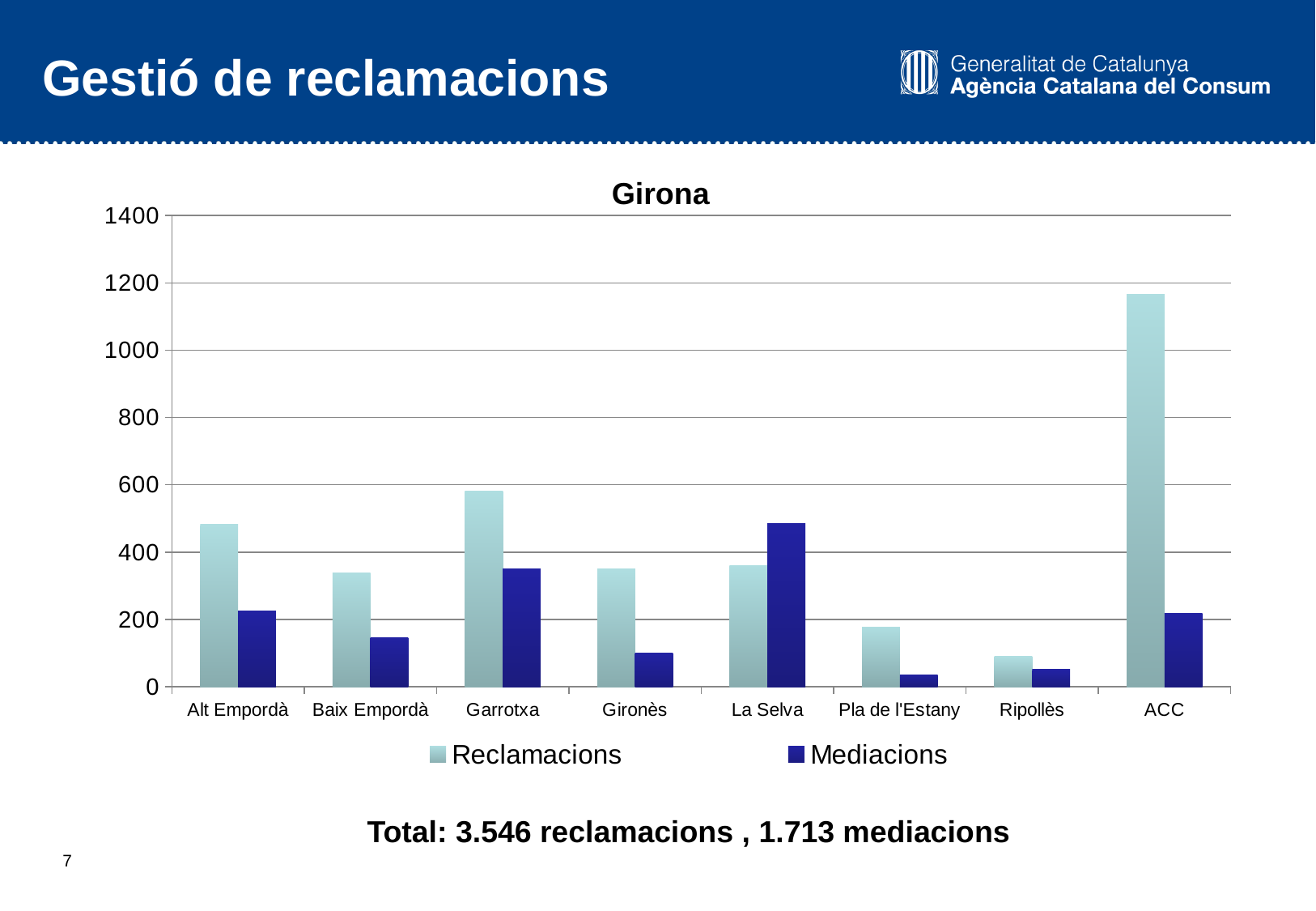
Is the Reclamacions value for ACC greater or less than 1000? greater Which category has the highest Mediacions value? La Selva What is the title of the chart? Girona Which category has the highest Reclamacions value? ACC How many categories are shown on the x axis? 8 Is the Mediacions value for Pla de l'Estany greater or less than 100? less What kind of chart is shown on the slide? bar chart Which category has the lowest Reclamacions value? Ripollès How many series does the legend list? 2 Which is larger: the Reclamacions value for Garrotxa or for Alt Empordà? Garrotxa Which category has the lowest Mediacions value? Pla de l'Estany For La Selva, which is larger: Reclamacions or Mediacions? Mediacions